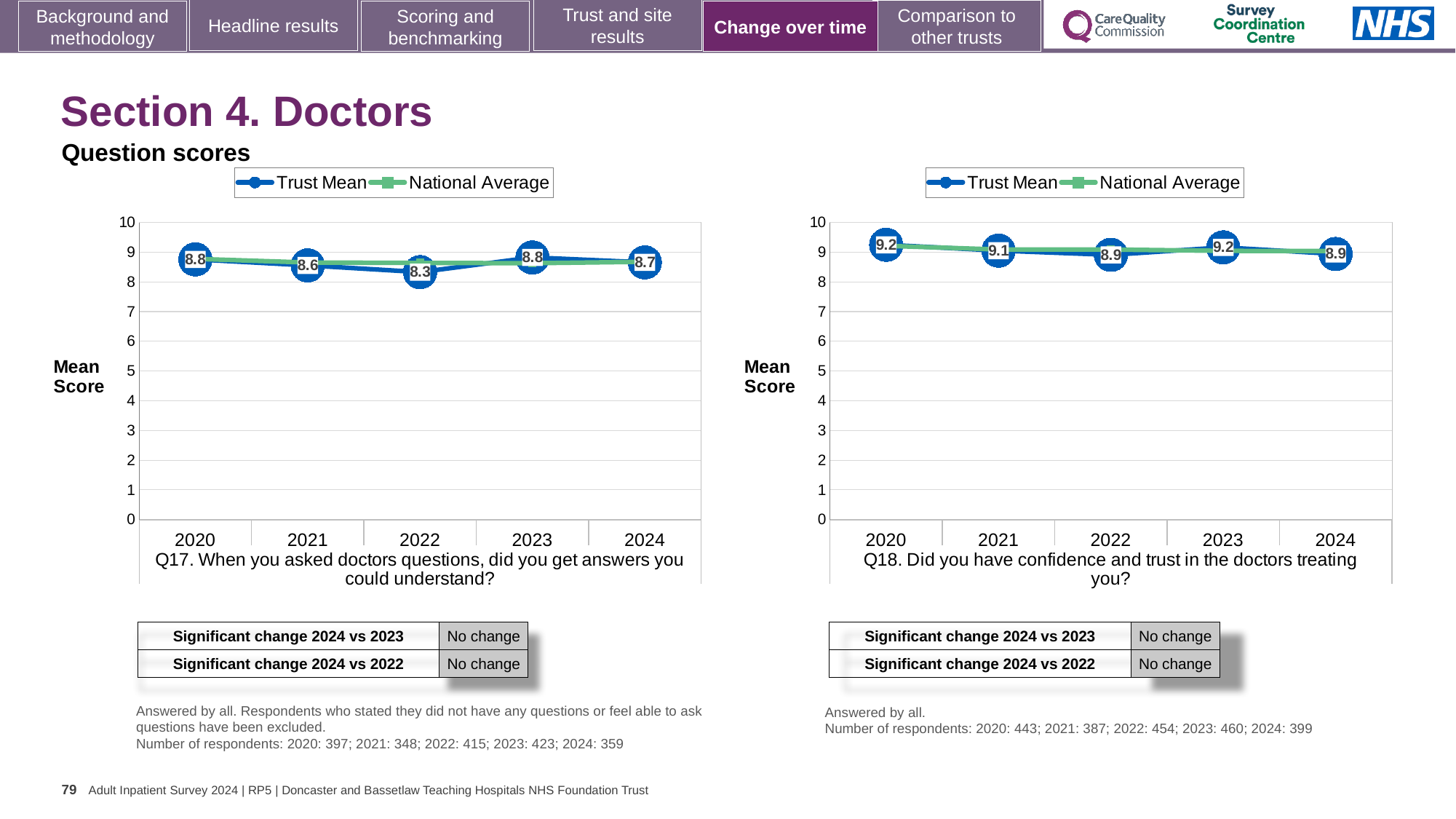
In the Q17 chart (left), what is the Trust Mean score for 2022? 8.3 In the Q17 chart (left), what is the Trust Mean score for 2020? 8.8 How many years are plotted on the x axis of the Q18 chart (right)? 5 What type of chart is used for Q18 (right)? Line chart In the Q18 chart (right), what is the difference between the Trust Mean scores for 2020 and 2024? 0.3 In the Q18 chart (right), which year has the lowest Trust Mean score? 2022 and 2024 (both 8.9) In the Q17 chart (left), is the Trust Mean score for 2021 greater or less than 8? greater In the Q17 chart (left), which year has the lowest Trust Mean score? 2022 In the Q18 chart (right), what is the Trust Mean score for 2024? 8.9 How many series does the legend of the Q17 chart (left) list? 2 In the Q18 chart (right), what is the Trust Mean score for 2021? 9.1 In the Q17 chart (left), what is the difference between the Trust Mean scores for 2023 and 2022? 0.5